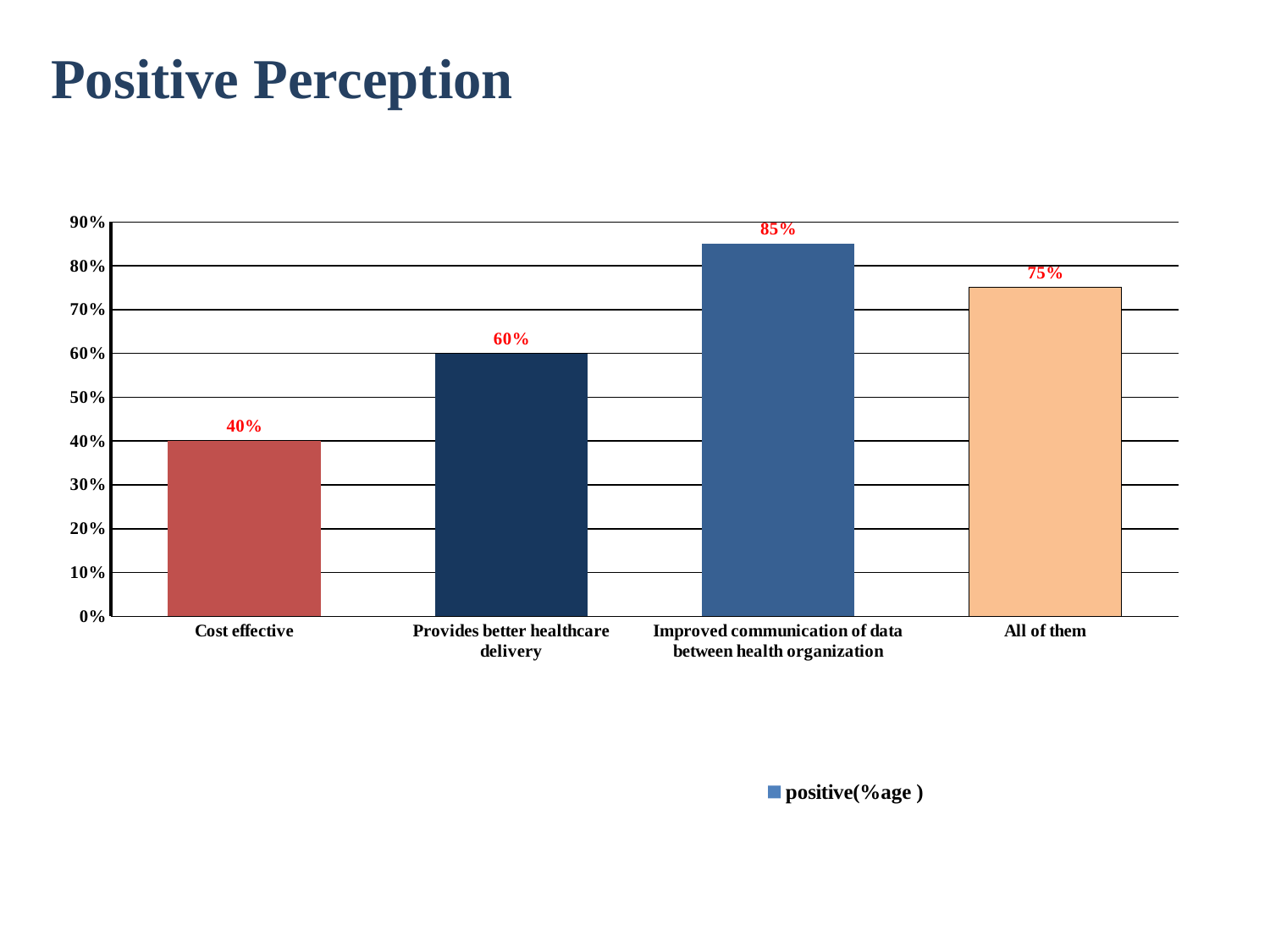
What is the difference between the values for Improved communication of data between health organization and Cost effective? 45% What is the value for All of them? 75% How many categories are shown on the x axis? 4 Which category has the lowest value? Cost effective Which is larger, the value for All of them or the value for Provides better healthcare delivery? All of them What is the difference between the values for All of them and Provides better healthcare delivery? 15% What series name does the legend show? positive(%age ) What is the value for Improved communication of data between health organization? 85% What kind of chart is shown on the slide? Bar chart What is the value for Provides better healthcare delivery? 60% Which category has the highest value? Improved communication of data between health organization What is the value for Cost effective? 40%